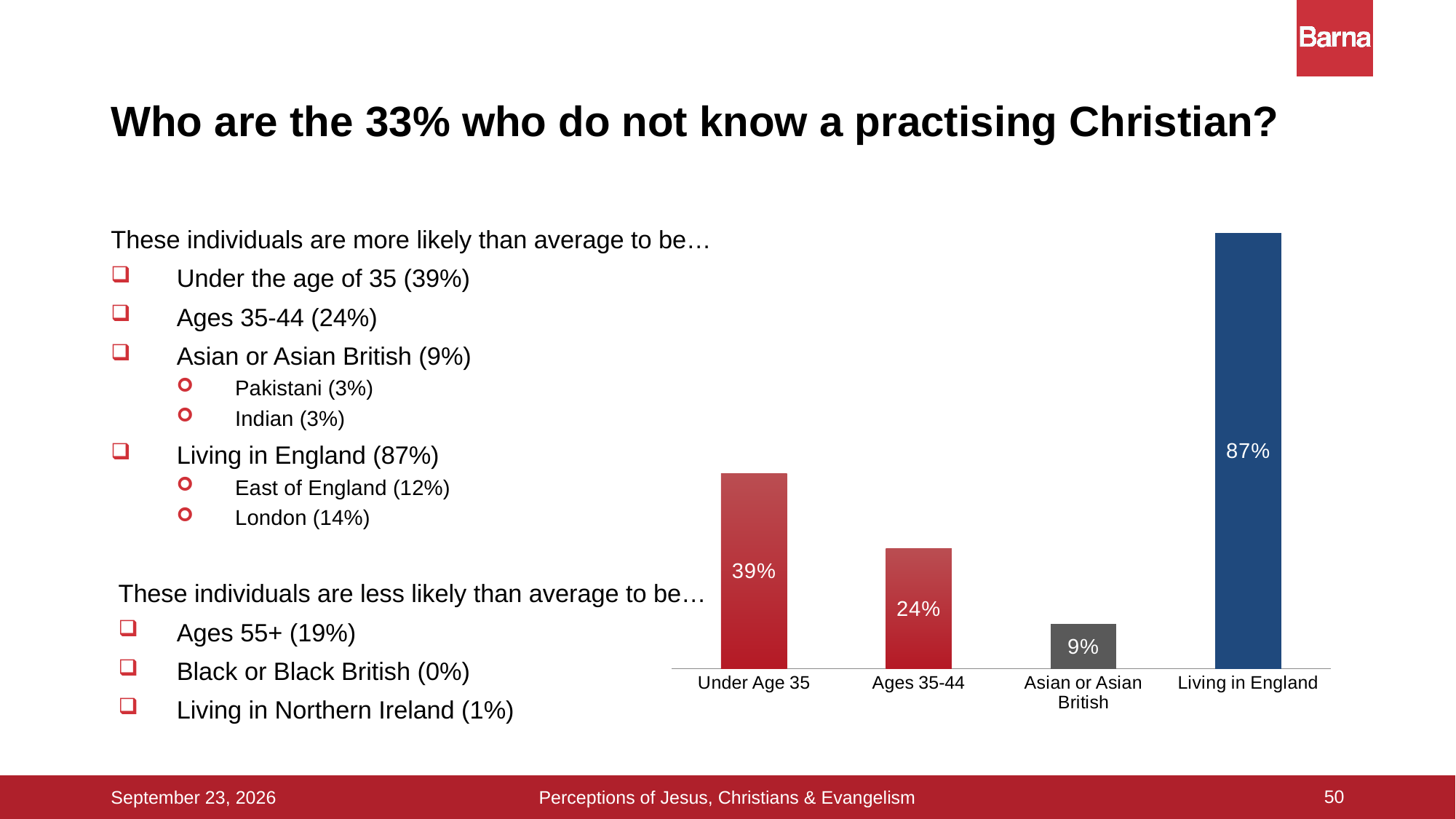
What is the difference between the values for Living in England and Under Age 35? 48% How many categories are shown in the chart? 4 What is the value for Living in England? 87% What is the value for Asian or Asian British? 9% What colour is the bar for Living in England? Blue Which is larger, the value for Ages 35-44 or the value for Asian or Asian British? Ages 35-44 What is the difference between the values for Under Age 35 and Ages 35-44? 15% What kind of chart is shown on the slide? Bar chart Which category has the lowest value? Asian or Asian British What is the value for Ages 35-44? 24% What is the value for Under Age 35? 39% Which category has the highest value? Living in England